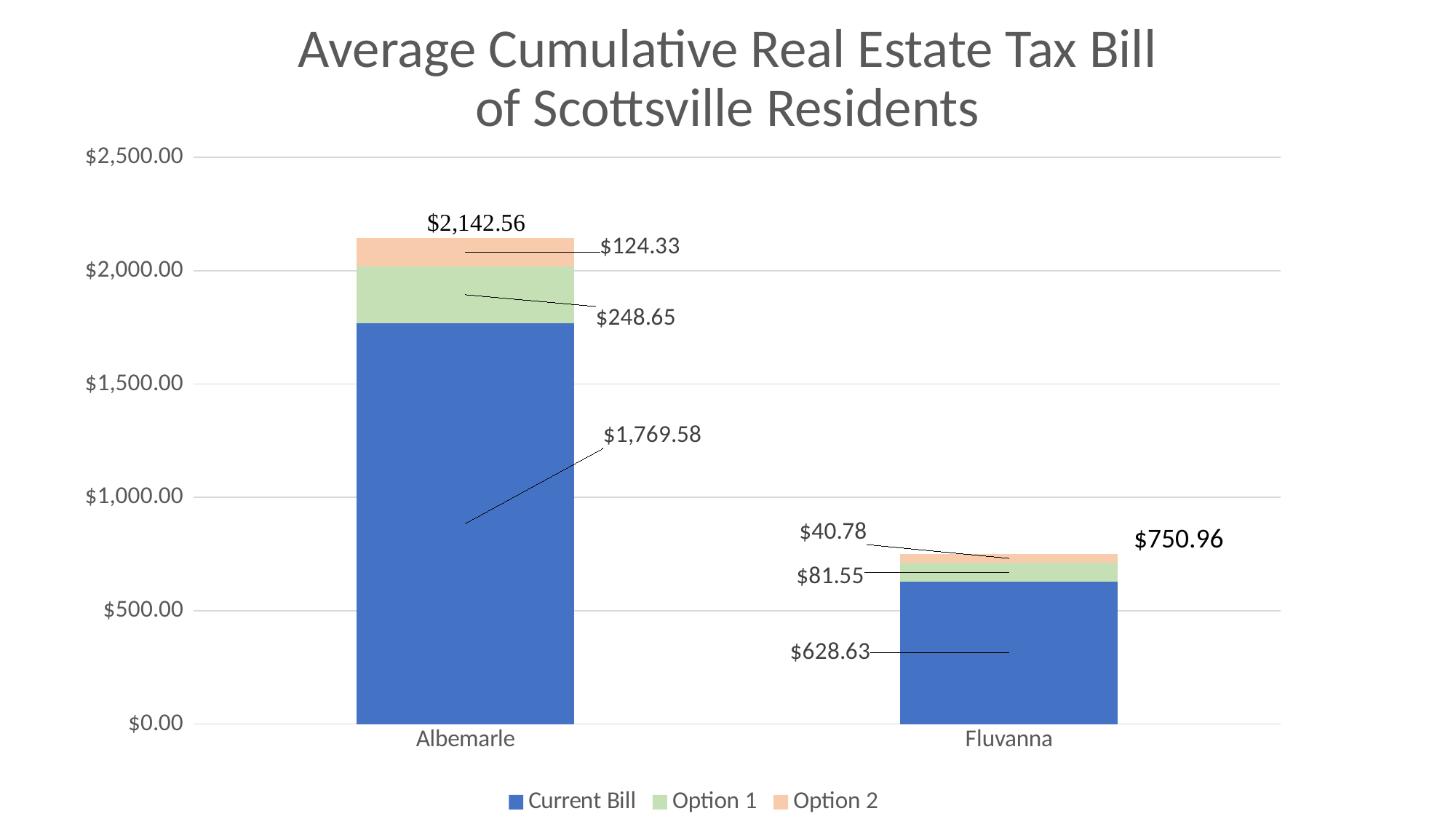
What is the total of the stacked bar for Albemarle? $2,142.56 What is the Current Bill value for Fluvanna? $628.63 What is the Option 1 value for Albemarle? $248.65 What is the Current Bill value for Albemarle? $1,769.58 Which category has the higher total cumulative tax bill? Albemarle What is the difference between the Current Bill values for Albemarle and Fluvanna? $1,140.95 What is the Option 2 value for Fluvanna? $40.78 What is the difference between the Option 1 values for Albemarle and Fluvanna? $167.10 What kind of chart is shown on the slide? stacked bar chart Is the Option 2 value for Albemarle larger or smaller than the Option 1 value for Albemarle? smaller What is the total of the stacked bar for Fluvanna? $750.96 How many series does the legend list? 3